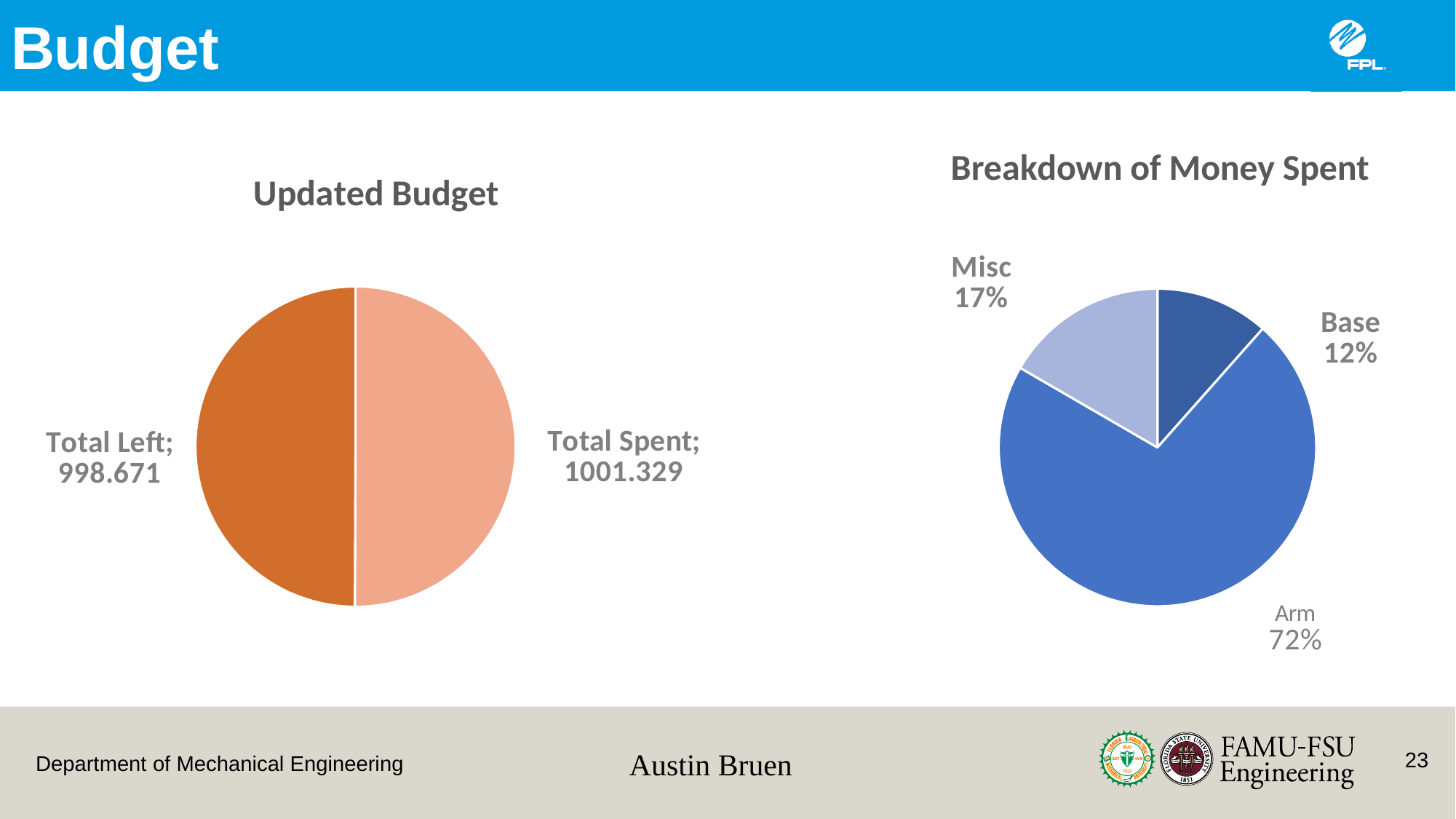
In the Breakdown of Money Spent chart, what share does Misc have? 17% What kind of chart is the Updated Budget chart? Pie chart In the Breakdown of Money Spent chart, which category has the largest share? Arm In the Breakdown of Money Spent chart, what share does Base have? 12% In the Updated Budget chart, what is the difference between Total Spent and Total Left? 2.658 In the Breakdown of Money Spent chart, how many categories are shown? 3 In the Updated Budget chart, what is the value for Total Left? 998.671 In the Updated Budget chart, what is the value for Total Spent? 1001.329 In the Breakdown of Money Spent chart, what share does Arm have? 72% In the Breakdown of Money Spent chart, which category has the smallest share? Base In the Updated Budget chart, how many slices does the pie have? 2 In the Updated Budget chart, which is larger, Total Spent or Total Left? Total Spent